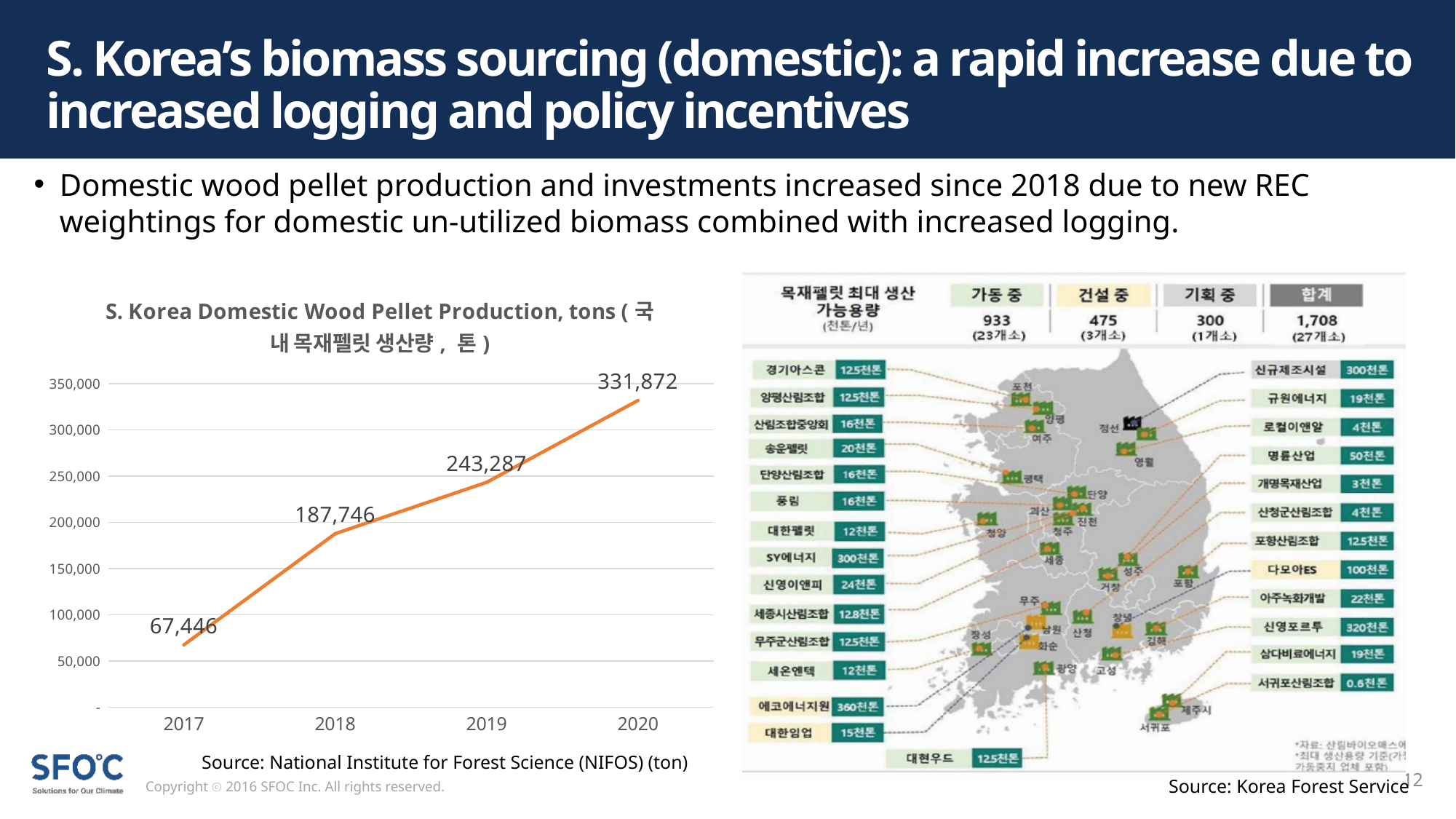
In the line chart 'S. Korea Domestic Wood Pellet Production, tons', what was the production in 2018? 187,746 In the line chart on the left, which year has the highest wood pellet production? 2020 In the line chart on the left, is the production in 2019 greater or less than 250,000? less In the line chart 'S. Korea Domestic Wood Pellet Production, tons', what was the production in 2019? 243,287 In the line chart on the left, which year has the lowest wood pellet production? 2017 In the line chart on the left, how many years are plotted? 4 In the line chart on the left, what is the difference in production between 2020 and 2019? 88,585 In the line chart on the left, what is the difference in production between 2018 and 2017? 120,300 In the line chart 'S. Korea Domestic Wood Pellet Production, tons', what was the production in 2020? 331,872 In the line chart 'S. Korea Domestic Wood Pellet Production, tons', what was the production in 2017? 67,446 What type of chart is the 'S. Korea Domestic Wood Pellet Production, tons' chart on the left? line chart In the line chart on the left, does wood pellet production rise or fall from 2017 to 2020? rise